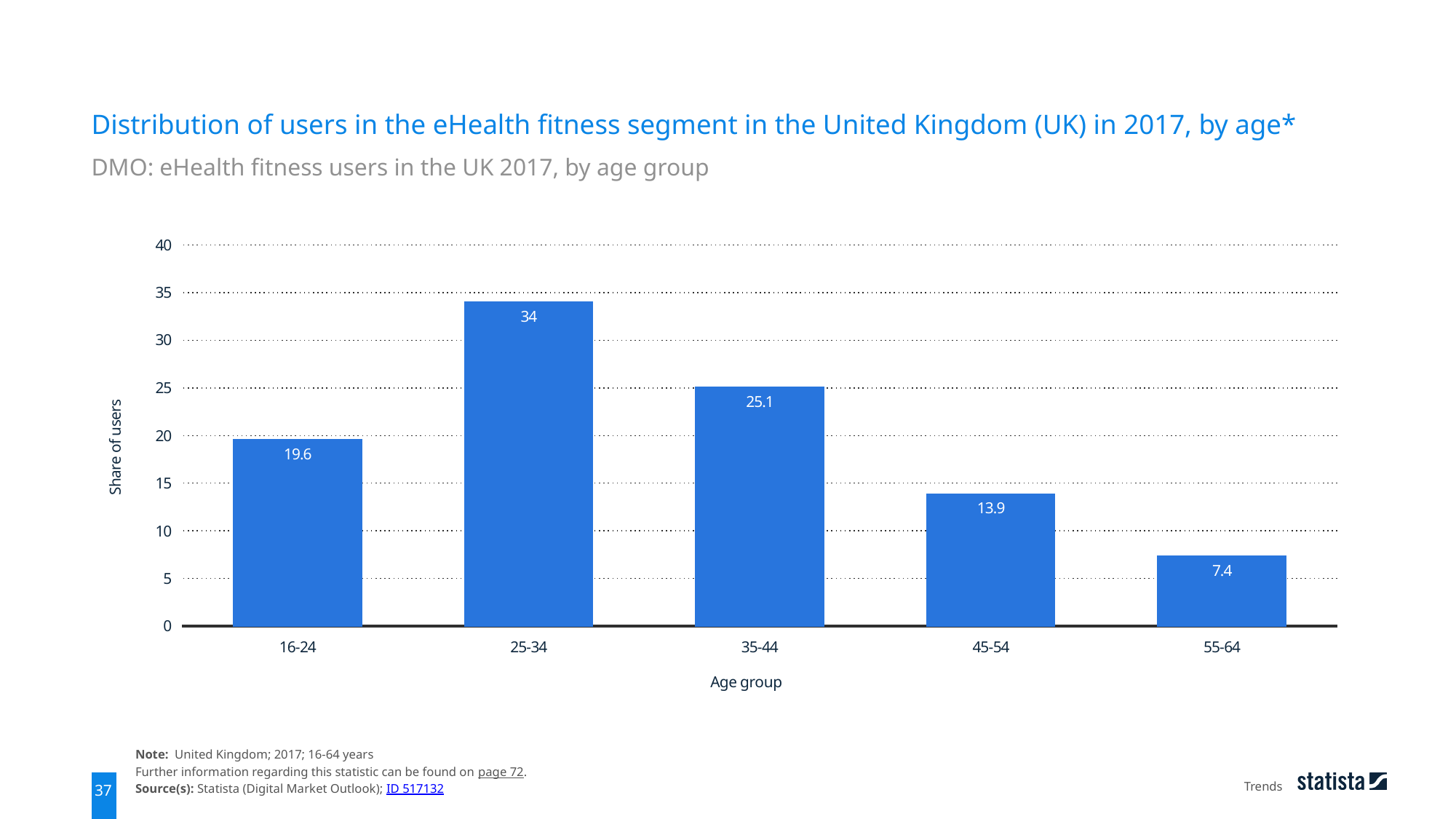
Do the values rise or fall from the 25-34 age group to the 55-64 age group? Fall What is the share of users for the 16-24 age group? 19.6 What is the share of users for the 55-64 age group? 7.4 What kind of chart is shown on the slide? Bar chart What is the label of the y axis? Share of users What is the share of users for the 25-34 age group? 34 Which age group has the highest share of users? 25-34 How many age groups are shown in the chart? 5 Which age group has the lowest share of users? 55-64 Which age group has a larger share of users, 16-24 or 45-54? 16-24 What is the difference in share of users between the 25-34 and 35-44 age groups? 8.9 Is the value for the 45-54 age group greater or less than 15? less